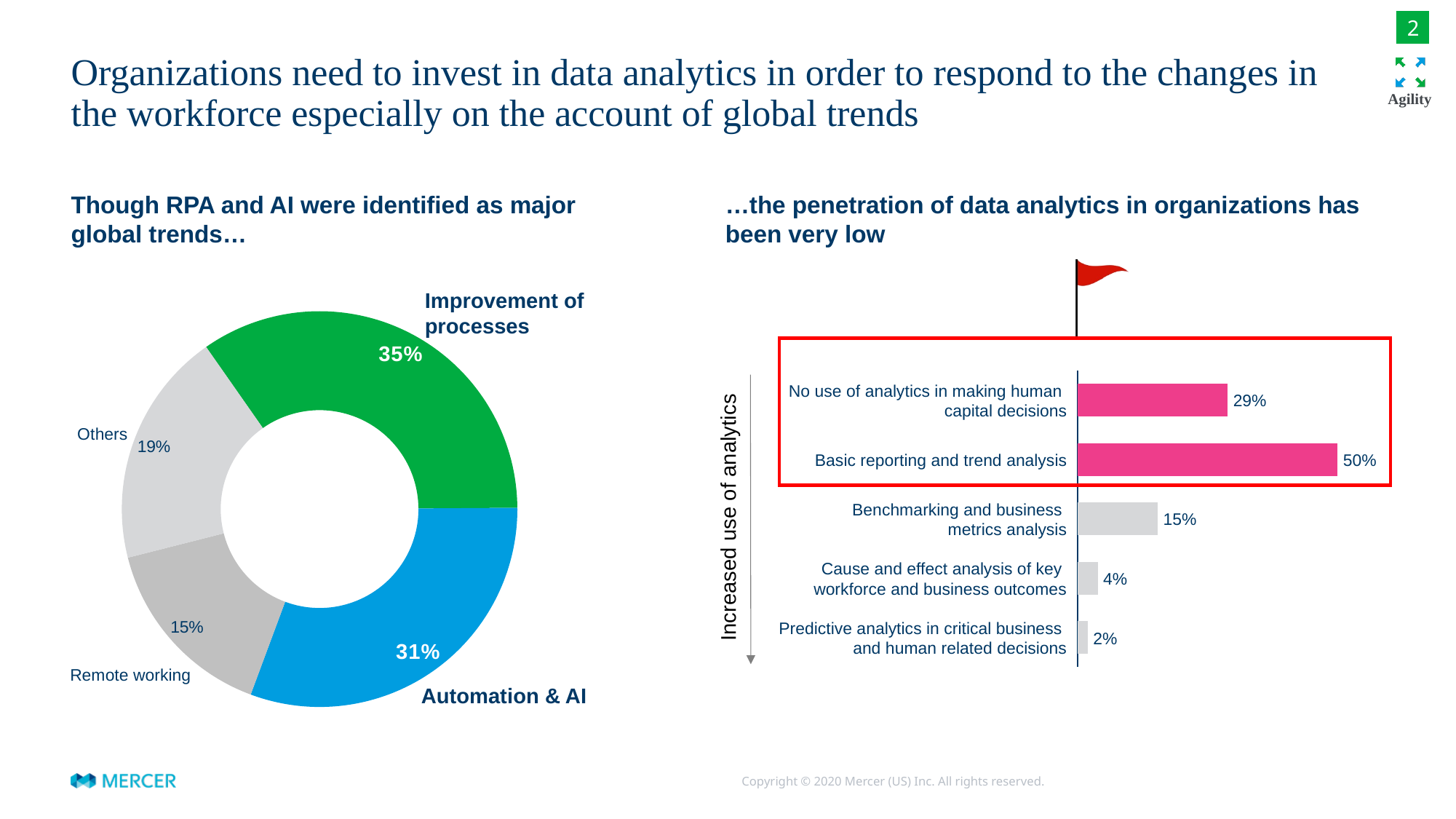
In the left chart (global trends donut), what share is labelled for Remote working? 15% In the left chart (global trends donut), how many categories are shown? 4 In the right chart (penetration of data analytics), what is the value for Basic reporting and trend analysis? 50% In the right chart (penetration of data analytics), which category has the highest value? Basic reporting and trend analysis In the left chart (global trends donut), what share is labelled for Improvement of processes? 35% In the left chart (global trends donut), which category has the smallest share? Remote working In the left chart (global trends donut), what is the difference between the shares for Improvement of processes and Automation & AI? 4% What kind of chart is the left chart showing global trends? Pie (donut) chart What kind of chart is the right chart showing penetration of data analytics? Bar chart In the left chart (global trends donut), which category has the largest share? Improvement of processes In the right chart (penetration of data analytics), what is the difference between No use of analytics in making human capital decisions and Benchmarking and business metrics analysis? 14% In the right chart (penetration of data analytics), what is the value for Predictive analytics in critical business and human related decisions? 2%